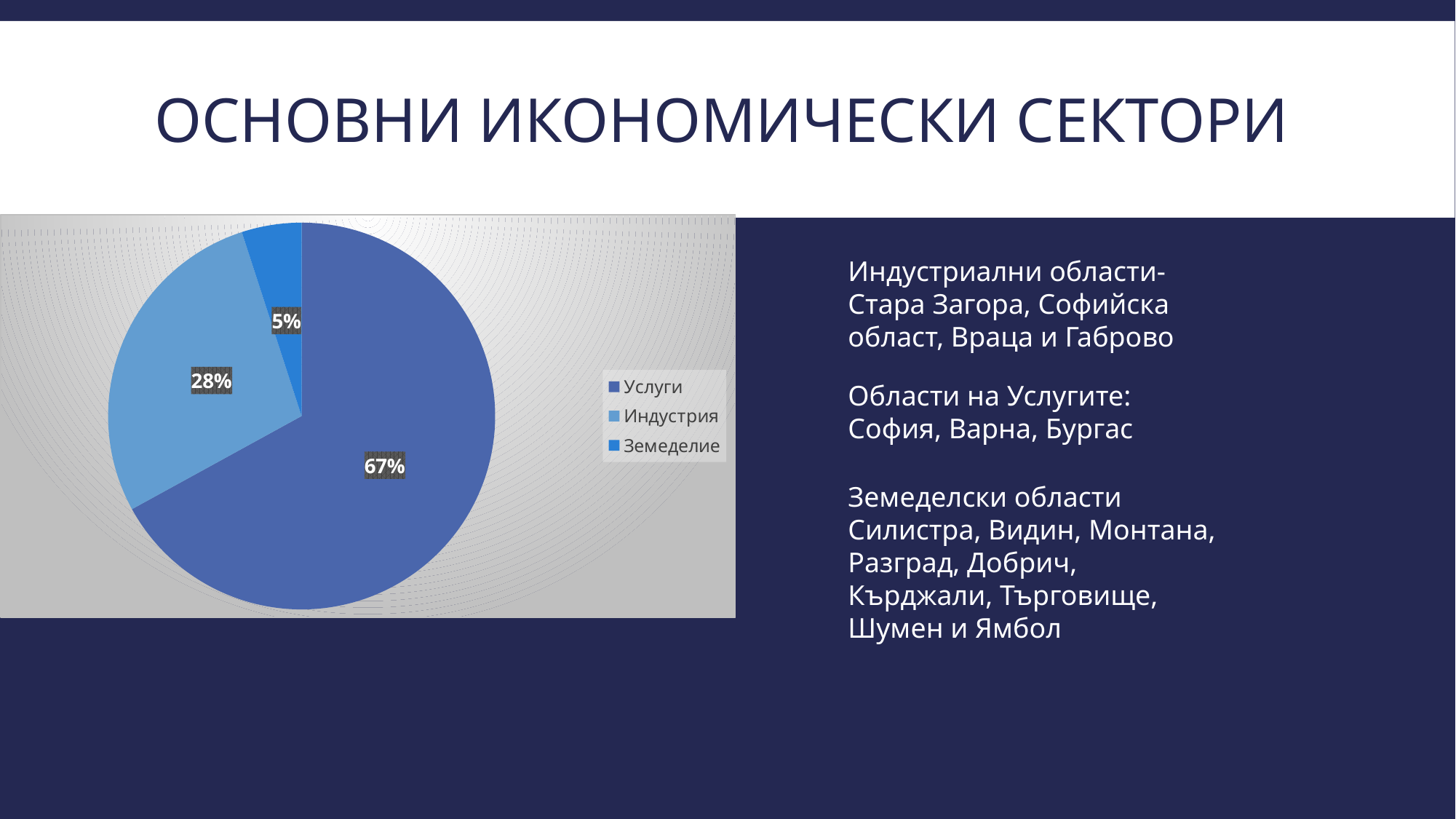
How many entries does the legend list? 3 What share of the pie does Индустрия have? 28% What share of the pie does Услуги have? 67% What kind of chart is shown on the slide? pie chart Which sector has the largest slice of the pie? Услуги Which is larger, the slice for Индустрия or the slice for Земеделие? Индустрия What is the difference in percentage points between Услуги and Индустрия? 39 Which legend entry is shown in the lightest blue colour? Индустрия What is the difference in percentage points between Индустрия and Земеделие? 23 What share of the pie does Земеделие have? 5% How many slices does the pie chart have? 3 Which sector has the smallest slice of the pie? Земеделие